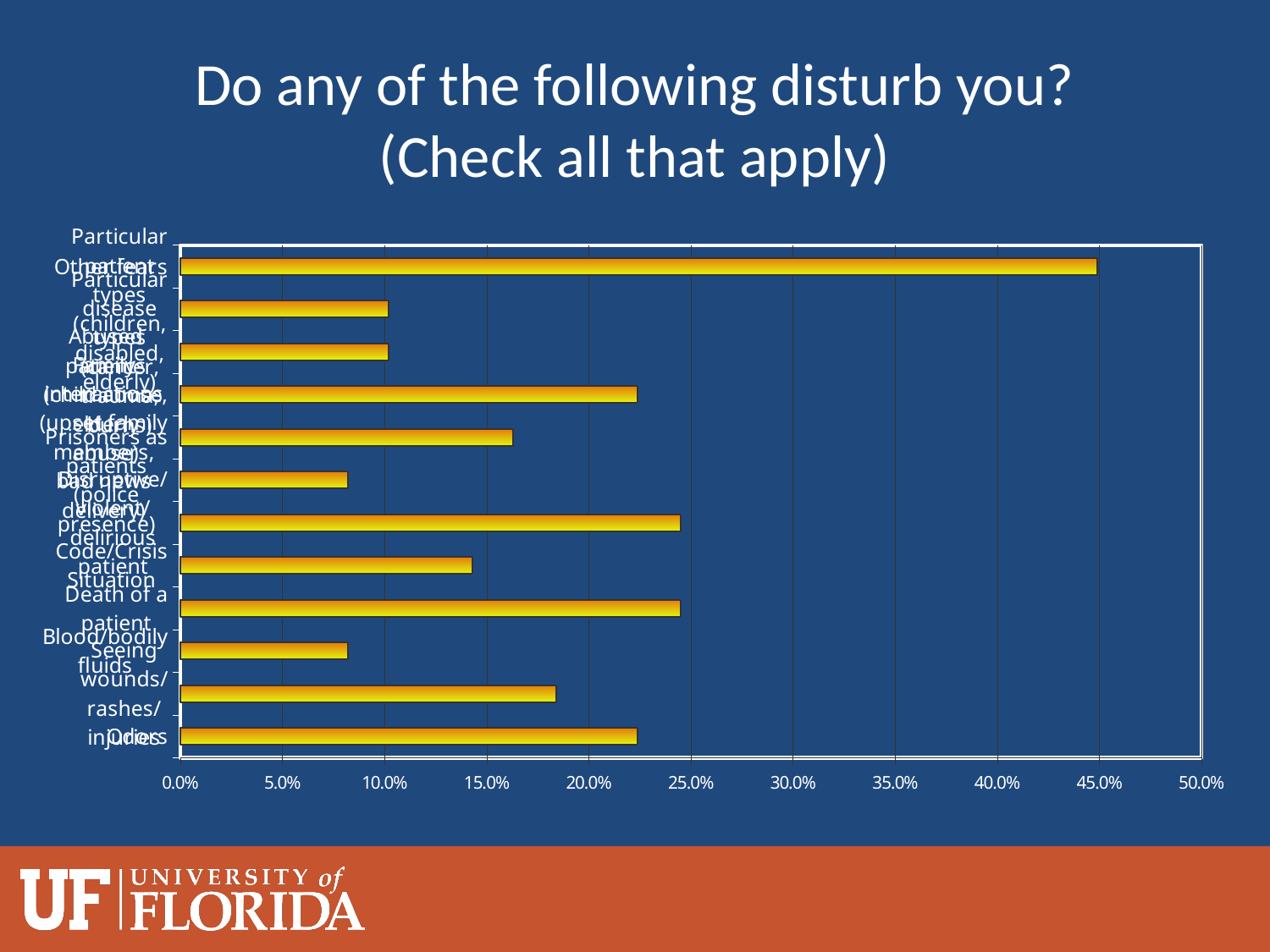
Is the value of the shortest bar in the chart greater or less than 10%? less What is the title of the slide containing the chart? Do any of the following disturb you? (Check all that apply) What kind of chart is shown on the slide? bar chart What is the highest value shown on the x axis? 50.0% How many bars in the chart exceed 30%? 1 Is the value of the longest bar in the chart greater or less than 40%? greater Is the value for Odors greater or less than 20%? greater How many bars are plotted in the chart? 12